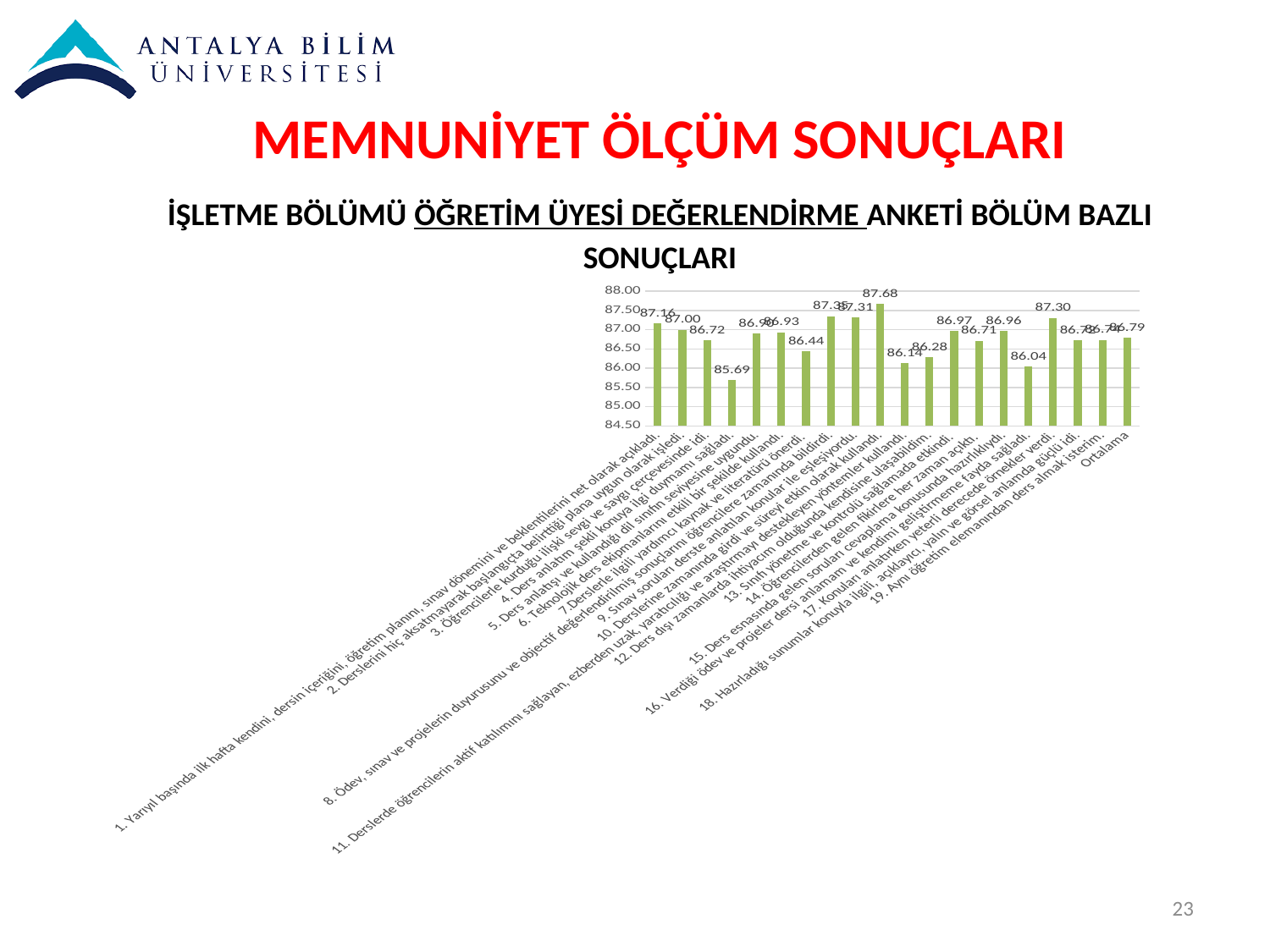
What is the value for item 10 ('Derslerine zamanında girdi ve süreyi etkin olarak kullandı')? 87.68 What is the value for item 4 ('Ders anlatım şekli konuya ilgi duymamı sağladı')? 85.69 Which is larger: the value for item 1 (87.16) or the 'Ortalama' value? item 1 (87.16) Is the value for item 4 ('Ders anlatım şekli konuya ilgi duymamı sağladı') greater or less than 86.00? less What type of chart is shown on the slide? bar chart How many bars are plotted in the chart? 20 What is the value for item 1 ('Yarıyıl başında ilk hafta kendini, dersin içeriğini, öğretim planını, sınav dönemini ve beklentilerini net olarak açıkladı')? 87.16 What is the difference between the highest value (87.68) and the lowest value (85.69)? 1.99 Which item has the lowest value in the chart? 4. Ders anlatım şekli konuya ilgi duymamı sağladı. What is the value for item 17 ('Konuları anlatırken yeterli derecede örnekler verdi')? 87.30 What is the value of the 'Ortalama' bar? 86.79 Which item has the highest value in the chart? 10. Derslerine zamanında girdi ve süreyi etkin olarak kullandı.